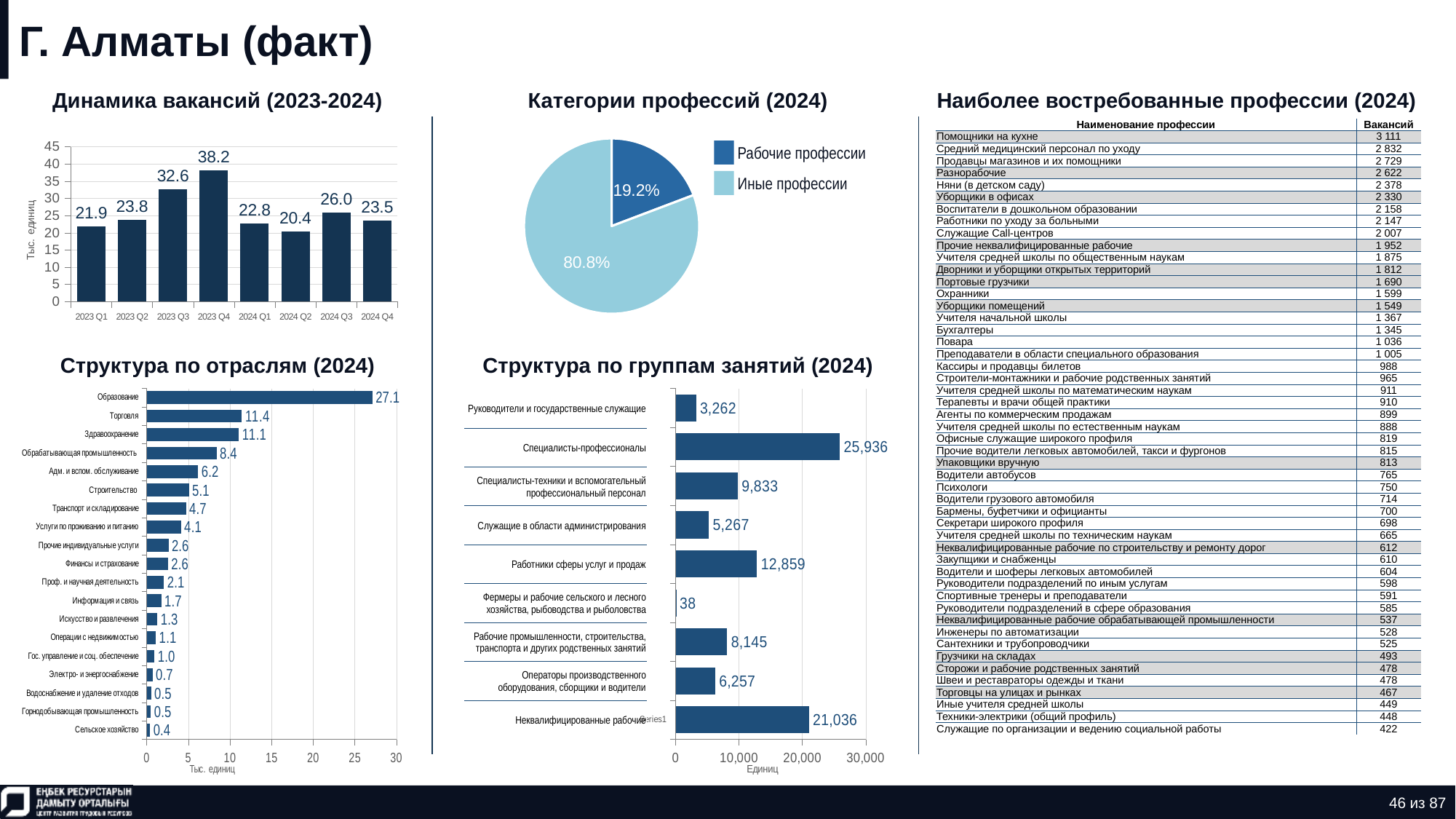
In the chart 'Структура по отраслям (2024)', what is the value for 'Торговля'? 11.4 What kind of chart is 'Категории профессий (2024)'? Pie chart In the chart 'Структура по группам занятий (2024)', which category has the lowest value? Фермеры и рабочие сельского и лесного хозяйства, рыбоводства и рыболовства In the chart 'Динамика вакансий (2023-2024)', what is the value for 2023 Q4? 38.2 In the chart 'Структура по отраслям (2024)', which is larger: 'Строительство' or 'Транспорт и складирование'? Строительство In the chart 'Динамика вакансий (2023-2024)', how many quarters are plotted? 8 In the chart 'Динамика вакансий (2023-2024)', what is the difference between 2023 Q4 and 2024 Q4? 14.7 In the chart 'Структура по группам занятий (2024)', what is the value for 'Работники сферы услуг и продаж'? 12,859 In the chart 'Структура по отраслям (2024)', which category has the highest value? Образование In the chart 'Динамика вакансий (2023-2024)', which quarter has the lowest value? 2024 Q2 What kind of chart is 'Структура по группам занятий (2024)'? Bar chart In the chart 'Категории профессий (2024)', what share of the pie is 'Рабочие профессии'? 19.2%